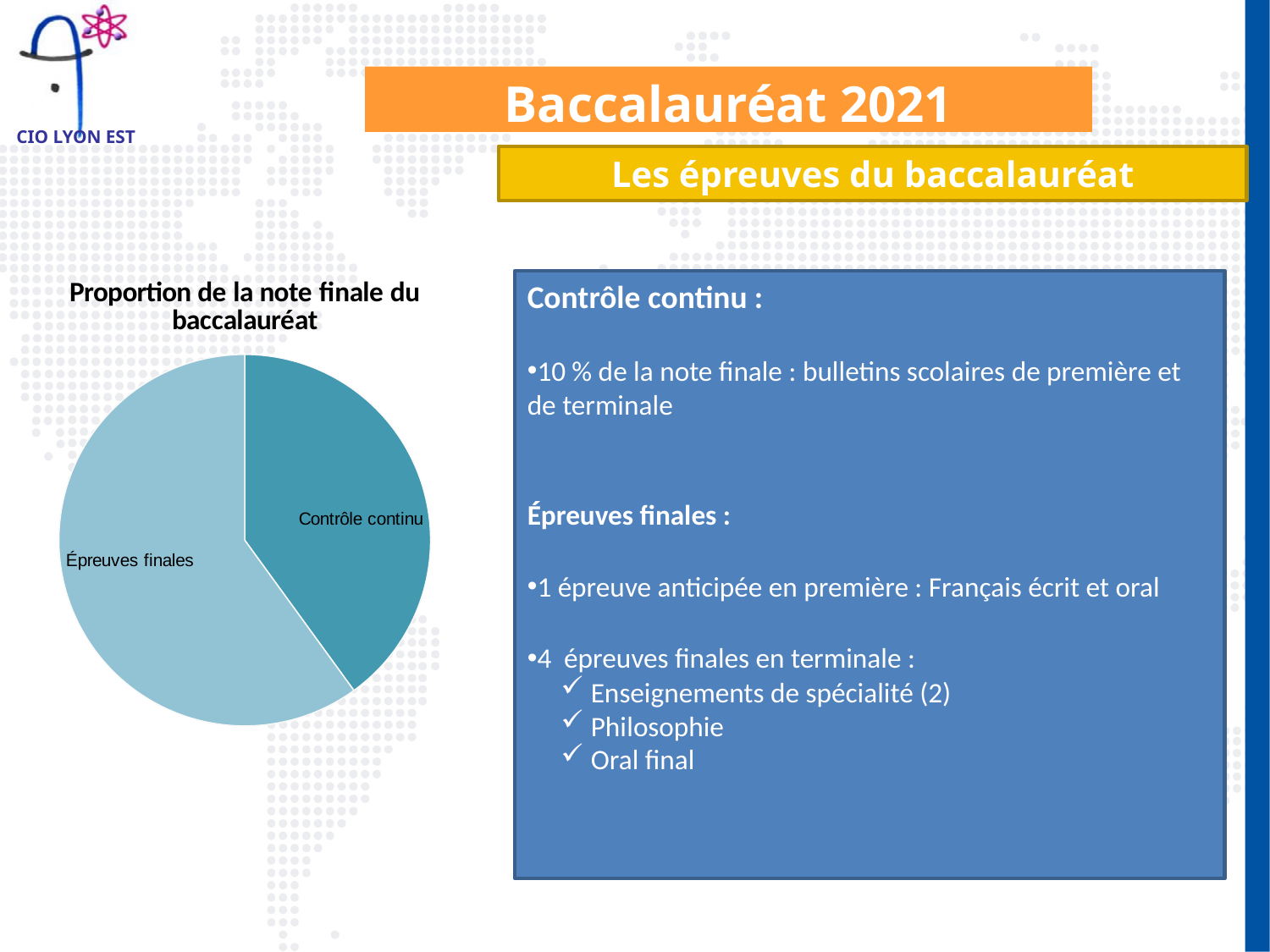
What is the title of the pie chart? Proportion de la note finale du baccalauréat How many slices does the pie chart have? 2 In the pie chart, which is larger: Contrôle continu or Épreuves finales? Épreuves finales Does the Épreuves finales slice take up more or less than half of the pie chart? More What kind of chart is shown on the slide? Pie chart Which slice of the pie chart is the smallest? Contrôle continu Which slice of the pie chart is the largest? Épreuves finales What are the labels of the two slices in the pie chart? Contrôle continu and Épreuves finales